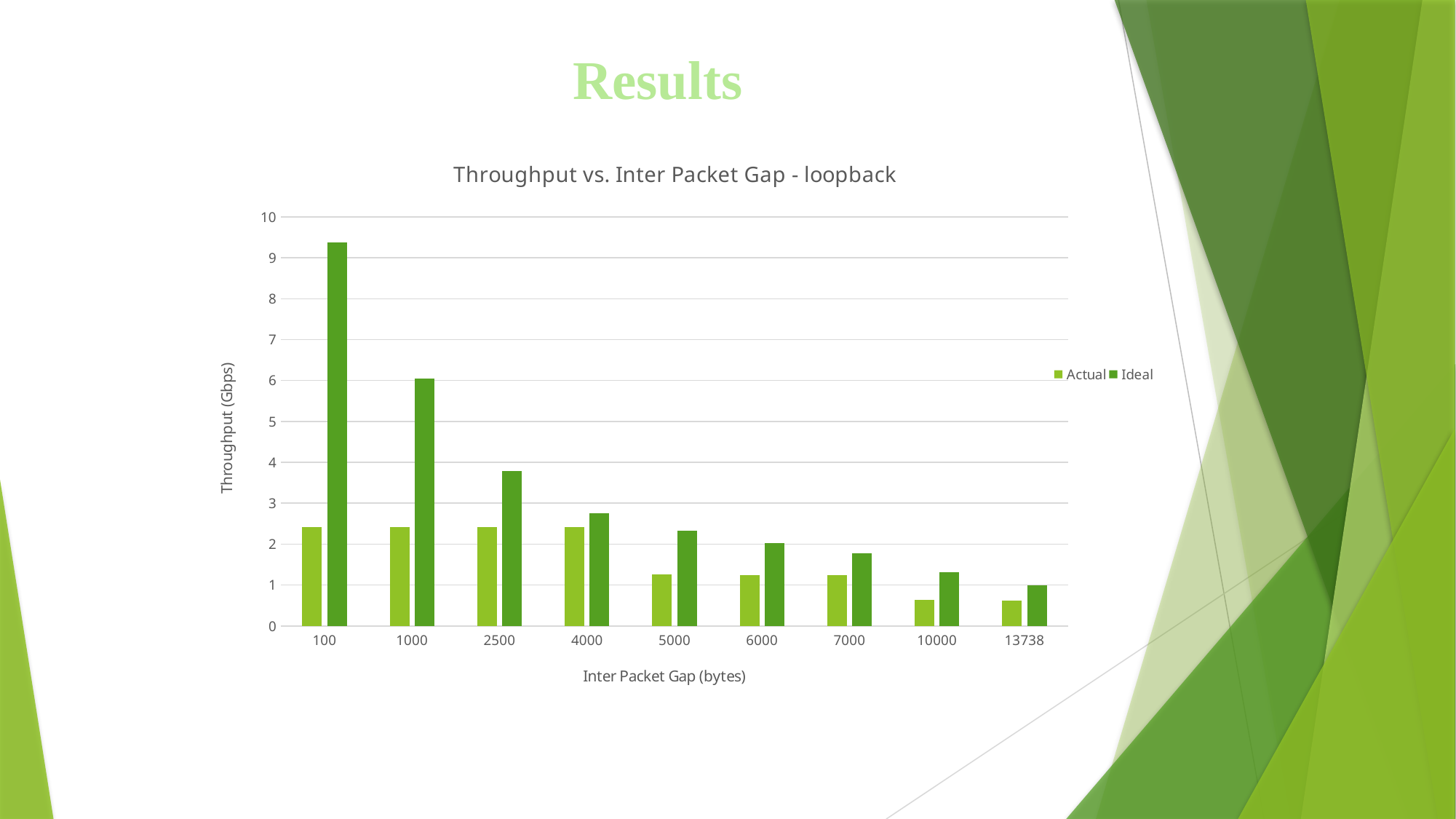
At which inter packet gap is the Ideal throughput lowest? 13738 Does the Ideal throughput rise or fall as the inter packet gap increases along the x axis? fall What is the title of the chart? Throughput vs. Inter Packet Gap - loopback How many inter packet gap categories are shown on the x axis? 9 How many series does the legend list? 2 What kind of chart is shown on the slide? bar chart Is the Ideal value at an inter packet gap of 100 greater or less than 9? greater At which inter packet gap is the Ideal throughput highest? 100 Is the Ideal value at an inter packet gap of 2500 greater or less than 4? less Is the Actual value at an inter packet gap of 5000 greater or less than 1? greater At an inter packet gap of 7000, which is larger, the Actual or the Ideal throughput? Ideal